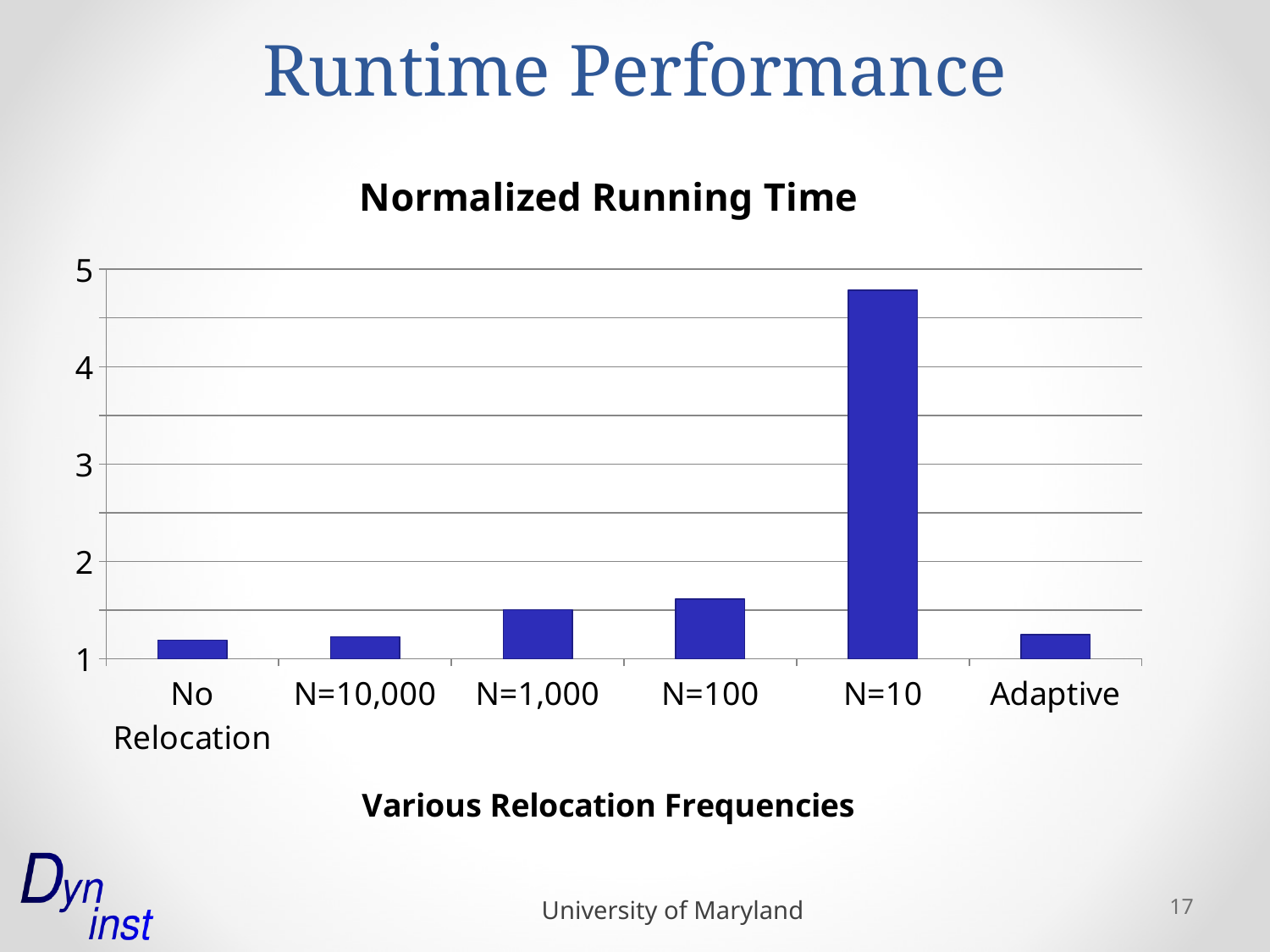
How many categories are plotted on the chart? 6 Which has a larger normalized running time, N=10 or N=100? N=10 Is the value for No Relocation greater or less than 2? less What is the label on the horizontal axis of the chart? Various Relocation Frequencies Which has a larger normalized running time, N=100 or Adaptive? N=100 Is the value for N=10 greater or less than 4? greater Which has a larger normalized running time, N=1,000 or No Relocation? N=1,000 Is the value for N=100 greater or less than 2? less Which category has the highest normalized running time? N=10 What is the title of the chart? Normalized Running Time What kind of chart is shown on the slide? bar chart